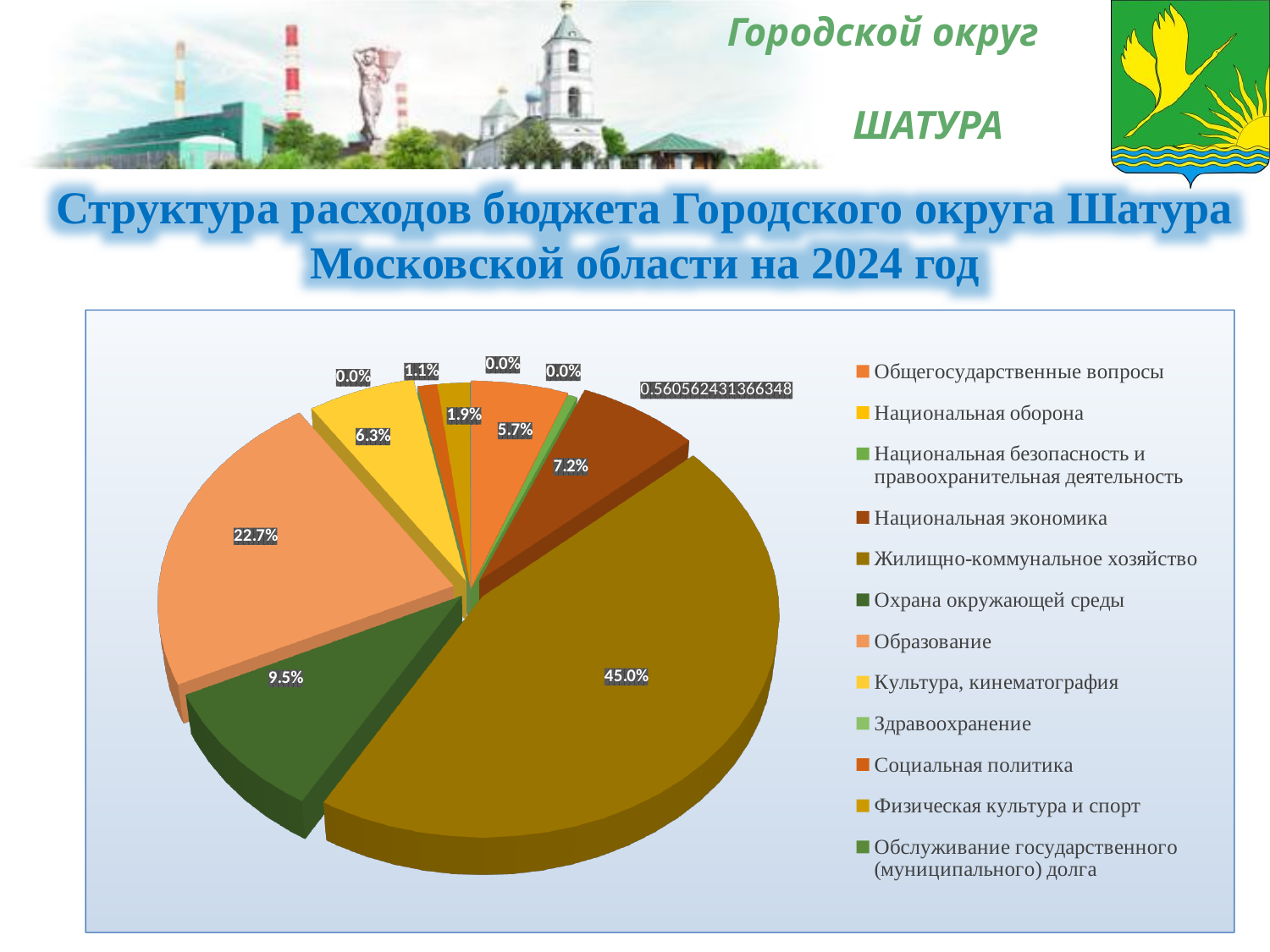
What is the share for Охрана окружающей среды? 9.5% What is the share for Культура, кинематография? 6.3% How many entries does the legend list? 12 What is the share for Национальная экономика? 7.2% What colour is the slice for Образование? light orange Which is larger, the share for Образование or the share for Охрана окружающей среды? Образование What is the share for Образование? 22.7% What kind of chart is shown on the slide? pie chart What is the difference between the shares for Жилищно-коммунальное хозяйство and Образование? 22.3% Which category has the largest share of the pie? Жилищно-коммунальное хозяйство What is the share for Общегосударственные вопросы? 5.7% What is the share for Жилищно-коммунальное хозяйство? 45.0%